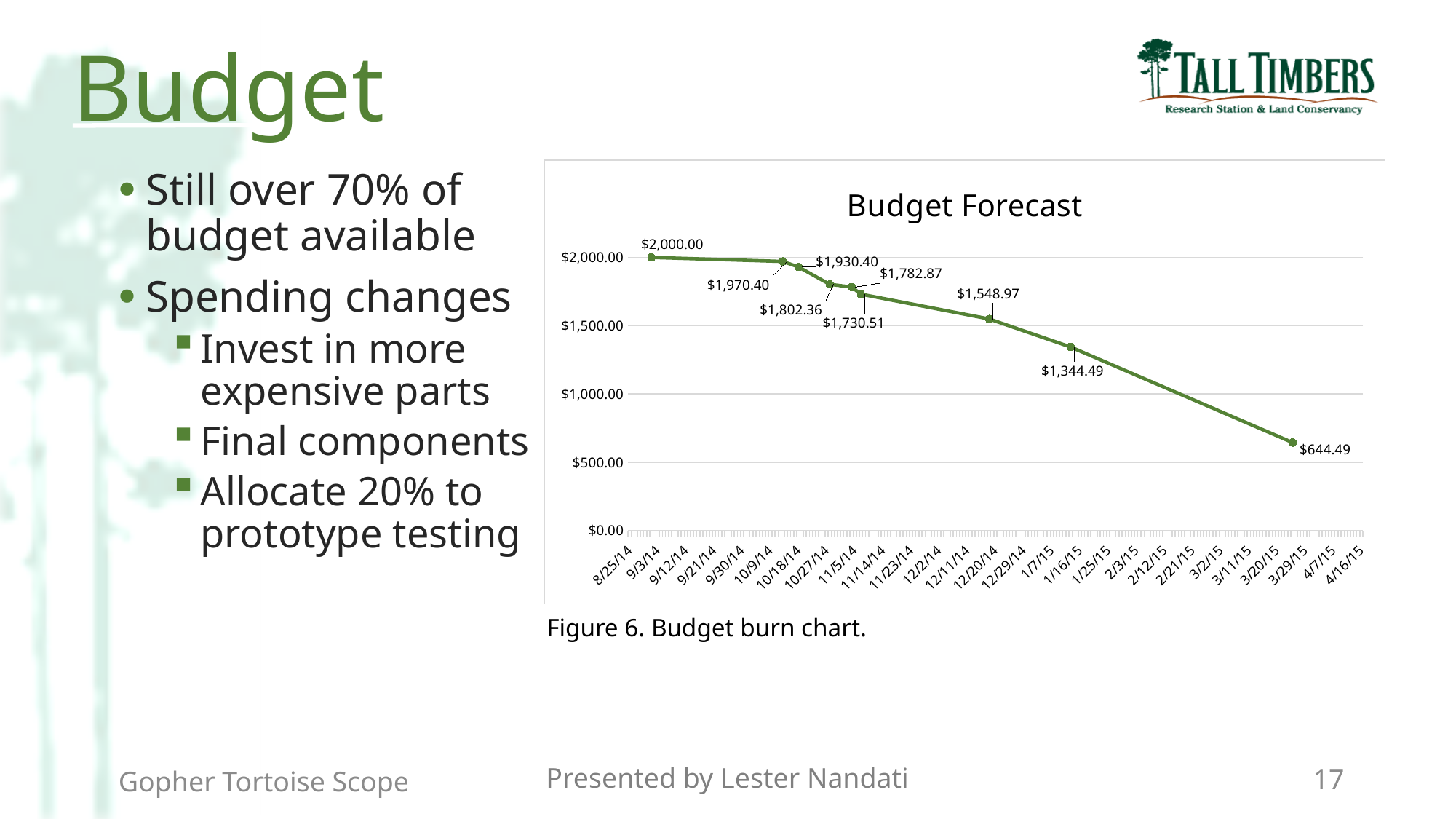
Do the values on the Budget Forecast chart rise or fall over time along the x axis? fall Is the final data point on the Budget Forecast chart greater or less than $1,000.00? less What is the lowest value plotted on the Budget Forecast chart? $644.49 What is the highest value plotted on the Budget Forecast chart? $2,000.00 How many data points are plotted on the Budget Forecast line? 9 What is the title of the chart? Budget Forecast What is the value of the first data point on the Budget Forecast chart? $2,000.00 What is the figure caption below the chart? Figure 6. Budget burn chart. What is the difference between the $1,970.40 point and the $1,930.40 point on the Budget Forecast chart? $40.00 What is the difference between the $1,548.97 point and the $1,344.49 point on the Budget Forecast chart? $204.48 What is the difference between the first value ($2,000.00) and the last value ($644.49) on the Budget Forecast chart? $1,355.51 What kind of chart is shown on the slide? line chart